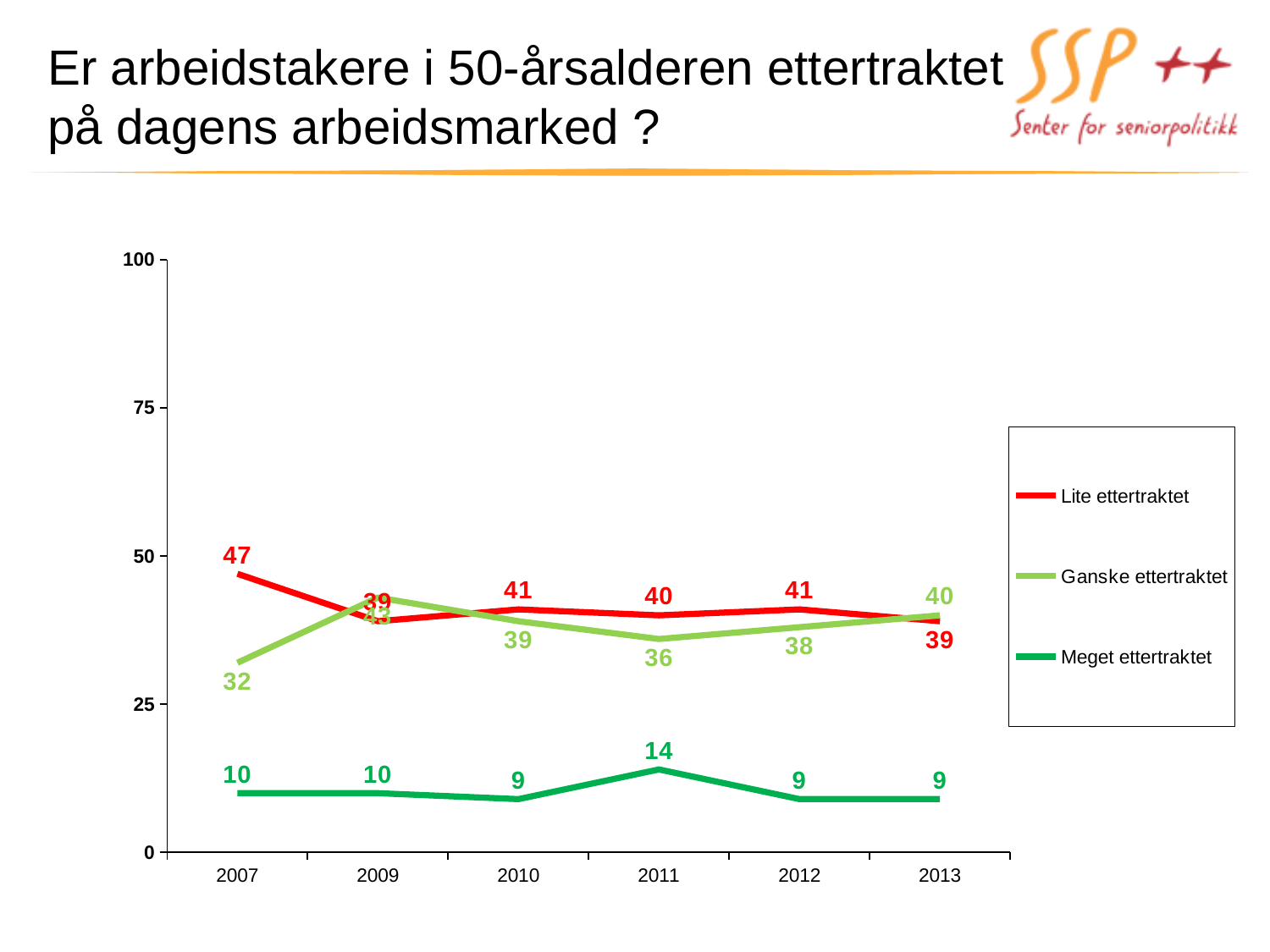
What type of chart is shown on the slide? line chart In which year is Lite ettertraktet at its highest? 2007 Which is larger in 2012, Lite ettertraktet or Meget ettertraktet? Lite ettertraktet What is the value for Lite ettertraktet in 2007? 47 How many years are plotted along the x axis? 6 In which year is Ganske ettertraktet at its lowest? 2007 What is the value for Ganske ettertraktet in 2013? 40 Which series is drawn in red? Lite ettertraktet What is the value for Meget ettertraktet in 2011? 14 What is the value for Ganske ettertraktet in 2011? 36 What is the difference between Lite ettertraktet in 2007 and in 2013? 8 How many series does the legend list? 3